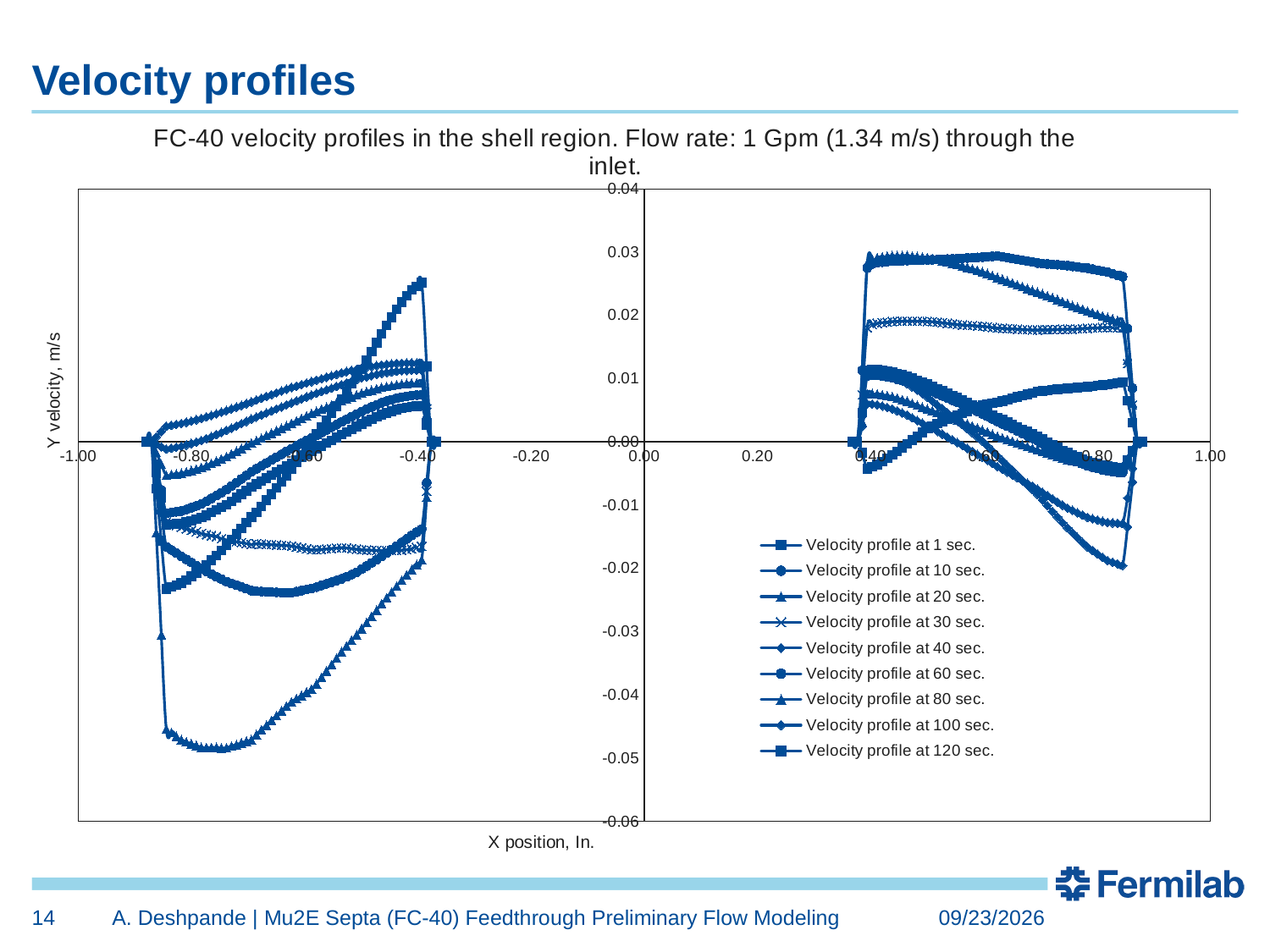
What kind of chart is shown on the slide? line chart What is the label of the vertical axis? Y velocity, m/s Is the lowest plotted Y velocity value on the chart greater or less than -0.04? less Is the lowest plotted Y velocity value on the chart greater or less than -0.05? greater Is the highest plotted Y velocity value on the chart greater or less than 0.02? greater What is the maximum value shown on the vertical axis? 0.04 How many series does the legend list? 9 What is the title of the chart? FC-40 velocity profiles in the shell region. Flow rate: 1 Gpm (1.34 m/s) through the inlet.